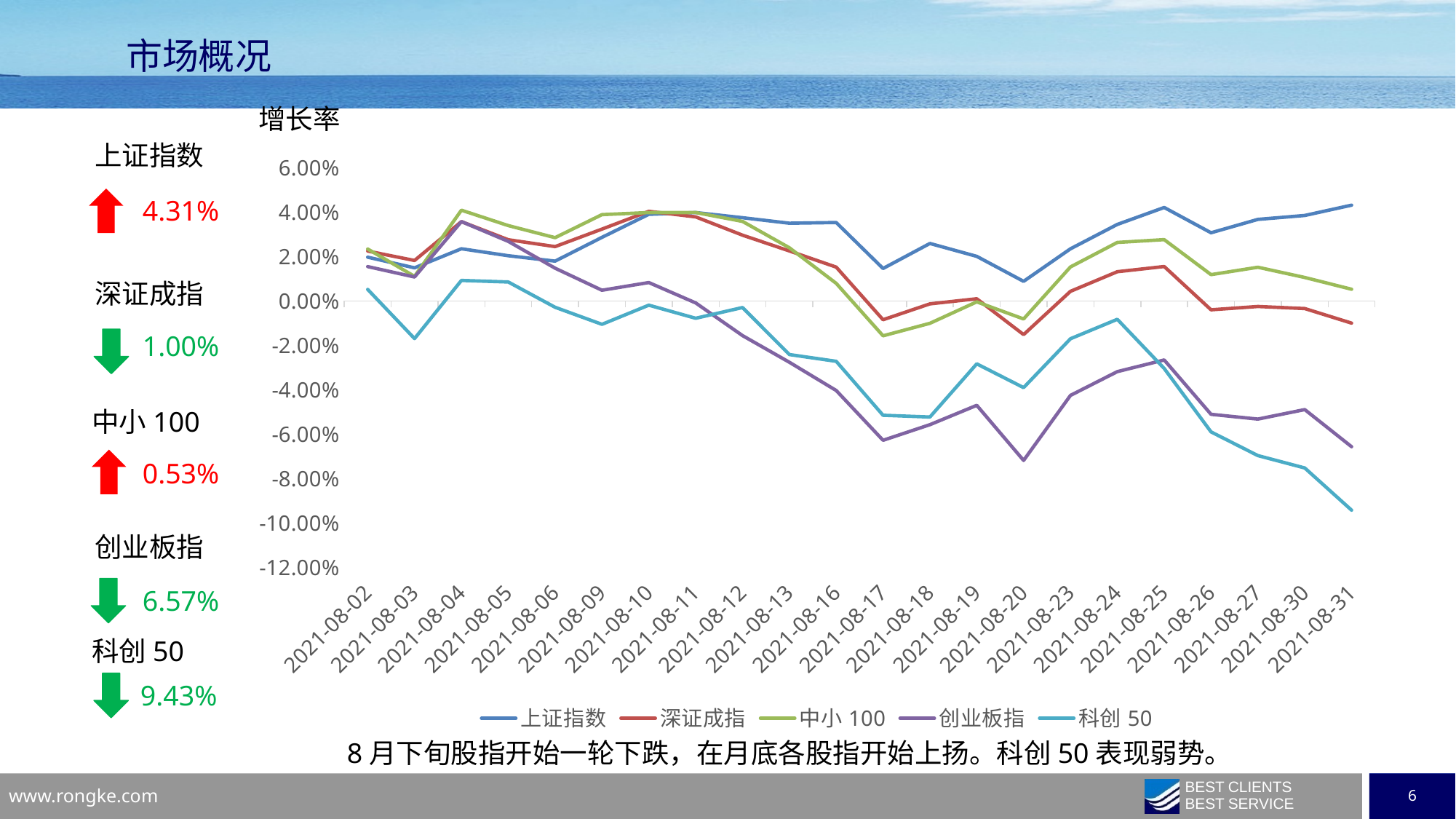
How many dates are plotted along the x axis of the chart? 22 Which series has the highest value on 2021-08-31? 上证指数 Which series has the lowest value on 2021-08-31? 科创 50 What kind of chart is shown on the slide? line chart On 2021-08-31, which is larger: the value for 上证指数 or the value for 科创 50? 上证指数 Is the value for 科创 50 on 2021-08-03 greater or less than 0.00%? less Is the value for 创业板指 on 2021-08-20 greater or less than -6.00%? less Is the value for 科创 50 on 2021-08-31 greater or less than -8.00%? less What is the label on the vertical axis of the chart? 增长率 Does the 科创 50 line rise or fall from 2021-08-25 to 2021-08-31? fall How many series does the chart legend list? 5